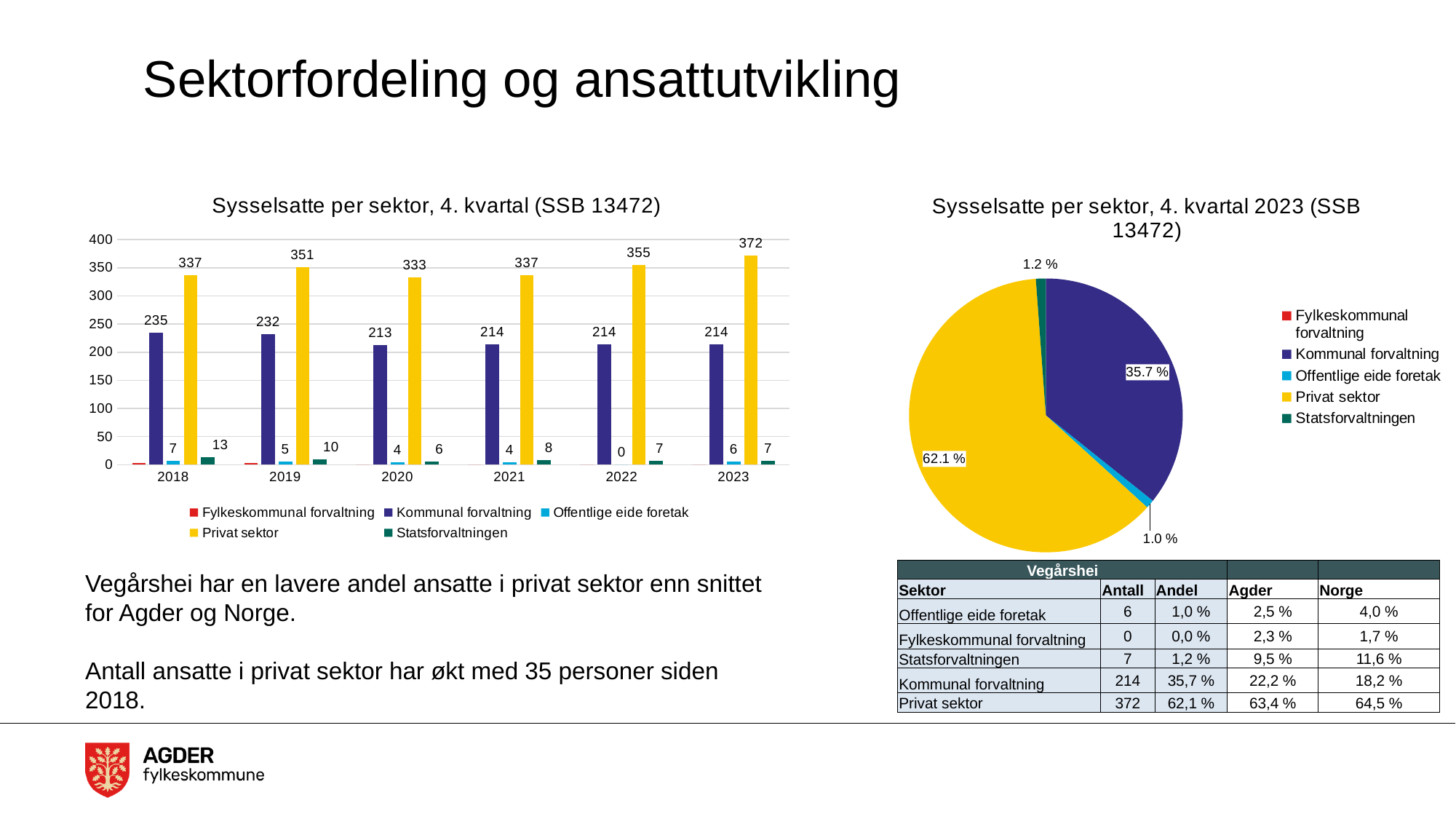
In the bar chart 'Sysselsatte per sektor, 4. kvartal (SSB 13472)', in which year is Privat sektor highest? 2023 In the bar chart 'Sysselsatte per sektor, 4. kvartal (SSB 13472)', what is the value for Kommunal forvaltning in 2018? 235 In the bar chart 'Sysselsatte per sektor, 4. kvartal (SSB 13472)', in which year is Privat sektor lowest? 2020 In the bar chart 'Sysselsatte per sektor, 4. kvartal (SSB 13472)', does Kommunal forvaltning rise or fall from 2018 to 2023? fall What kind of chart is 'Sysselsatte per sektor, 4. kvartal (SSB 13472)' on the left of the slide? bar chart In the bar chart 'Sysselsatte per sektor, 4. kvartal (SSB 13472)', which year has the larger value for Kommunal forvaltning, 2018 or 2019? 2018 In the bar chart 'Sysselsatte per sektor, 4. kvartal (SSB 13472)', how many series does the legend list? 5 In the bar chart 'Sysselsatte per sektor, 4. kvartal (SSB 13472)', by how much did Privat sektor increase from 2018 to 2023? 35 In the pie chart 'Sysselsatte per sektor, 4. kvartal 2023 (SSB 13472)', what share does Privat sektor have? 62.1 % In the bar chart 'Sysselsatte per sektor, 4. kvartal (SSB 13472)', how many years are shown on the x axis? 6 In the bar chart 'Sysselsatte per sektor, 4. kvartal (SSB 13472)', what is the value for Statsforvaltningen in 2018? 13 In the bar chart 'Sysselsatte per sektor, 4. kvartal (SSB 13472)', what is the value for Privat sektor in 2023? 372